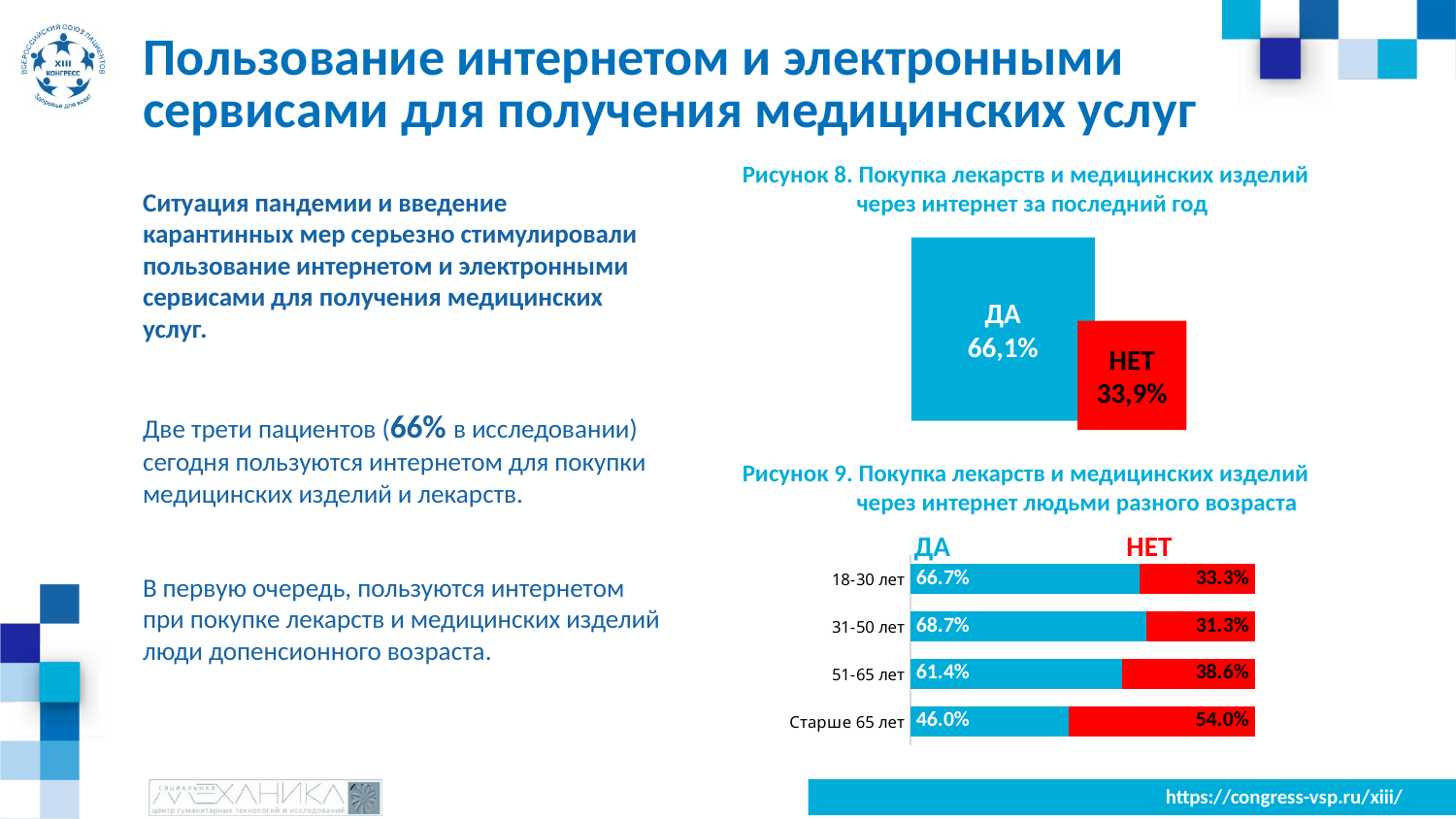
In Figure 8, which is larger, ДА or НЕТ? ДА In Figure 9, which age group has the highest ДА value? 31-50 лет In Figure 9, which age group has the lowest ДА value? Старше 65 лет In Figure 9, what is the НЕТ value for the Старше 65 лет group? 54.0% In Figure 9, what kind of chart is used? Stacked horizontal bar chart In Figure 9, what is the total of the ДА and НЕТ values for the 51-65 лет bar? 100.0% In Figure 9, what is the difference between the ДА values for 18-30 лет and Старше 65 лет? 20.7% In Figure 9, how many age groups are shown? 4 In Figure 9 (Покупка лекарств и медицинских изделий через интернет людьми разного возраста), what is the ДА value for the 31-50 лет group? 68.7% In Figure 8 (Покупка лекарств и медицинских изделий через интернет за последний год), what is the value for ДА? 66,1% In Figure 9, what is the ДА value for the 51-65 лет group? 61.4% In Figure 8 (Покупка лекарств и медицинских изделий через интернет за последний год), what is the value for НЕТ? 33,9%